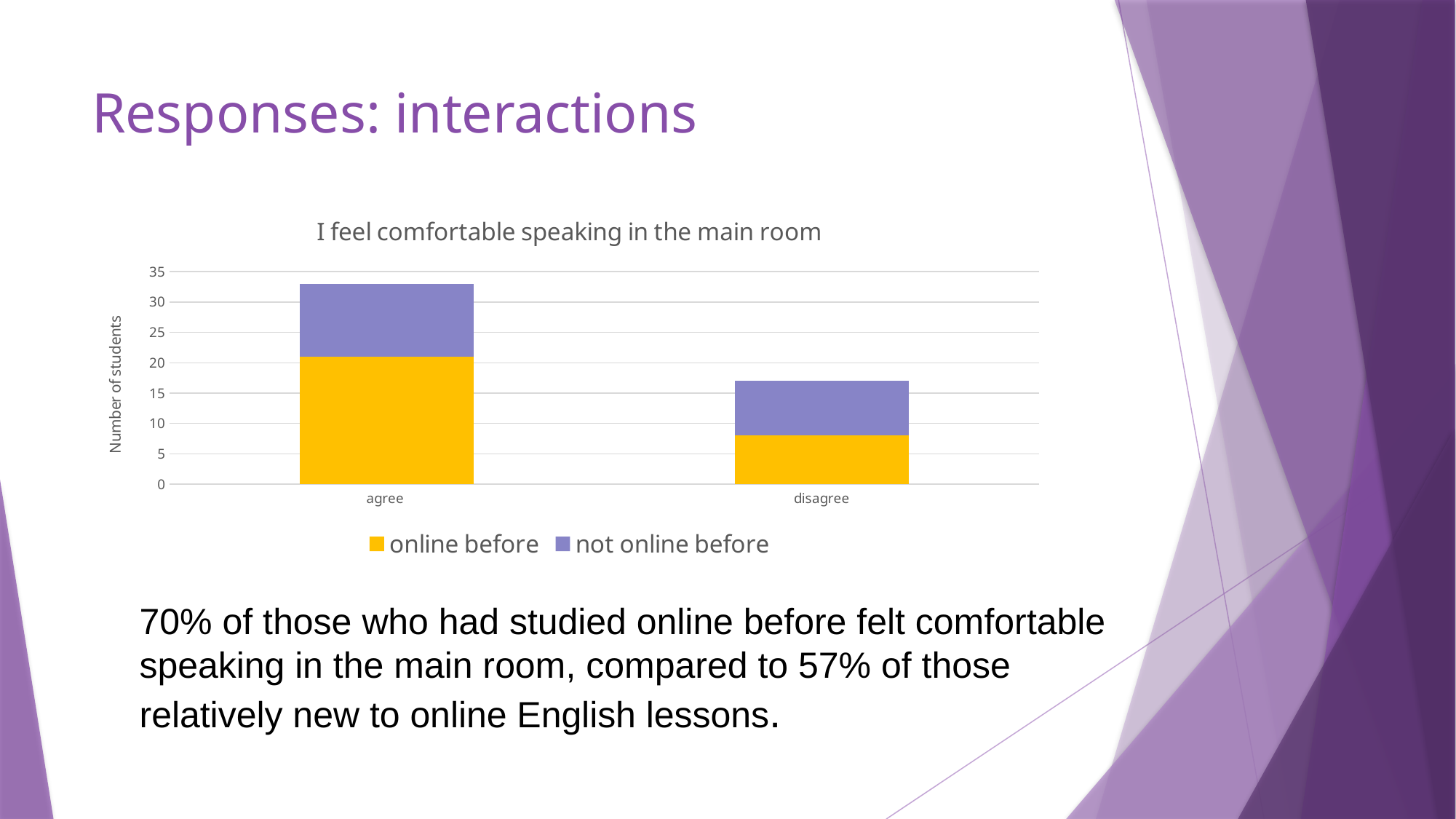
How many series does the legend list? 2 What is the title of the chart? I feel comfortable speaking in the main room Is the total height of the 'agree' bar greater or less than 30? greater Which category has the shorter stacked bar? disagree Is the 'online before' value for 'agree' greater or less than 15? greater What kind of chart is shown on the slide? stacked bar chart Is the 'online before' value for 'disagree' greater or less than 10? less Which category has the taller stacked bar? agree What is the label of the y axis? Number of students How many categories are shown on the x axis? 2 Which is larger: the 'online before' value for 'agree' or for 'disagree'? agree